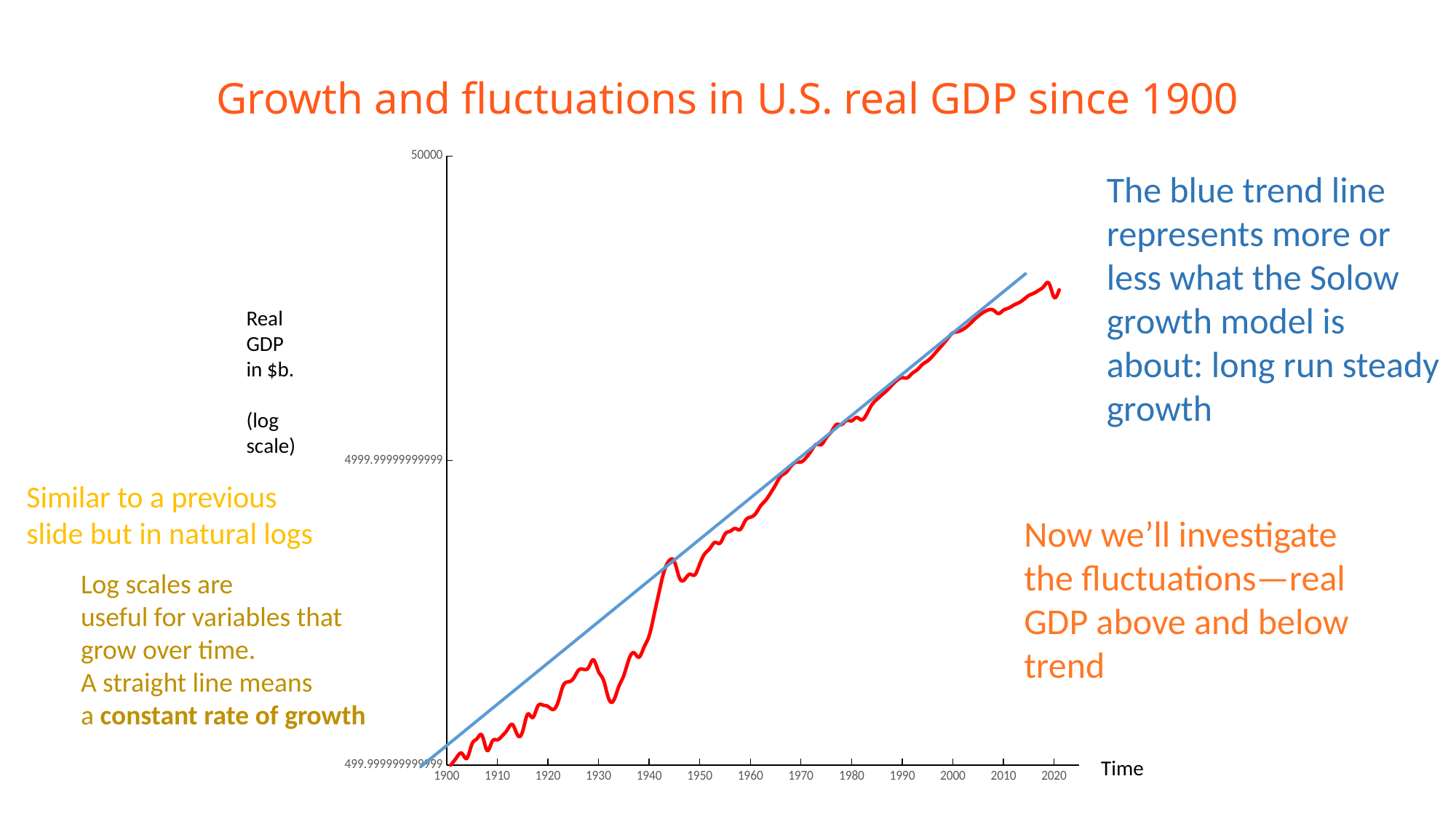
Is the value of real GDP in 1980 greater or less than 4999.99999999999? greater Does real GDP generally rise or fall from 1900 to 2020 along the x axis? rise Is the value of real GDP in 1920 greater or less than 4999.99999999999? less How many year tick labels are shown on the horizontal axis? 13 Which year has the lower real GDP, 1900 or 2000? 1900 What is the title of the slide's chart? Growth and fluctuations in U.S. real GDP since 1900 What is the label on the horizontal axis of the chart? Time Which year shown on the x axis has the lowest real GDP? 1900 What is the highest value labelled on the vertical axis? 50000 What kind of chart is shown on the slide? line chart Is the value of real GDP in 1960 greater or less than 4999.99999999999? less